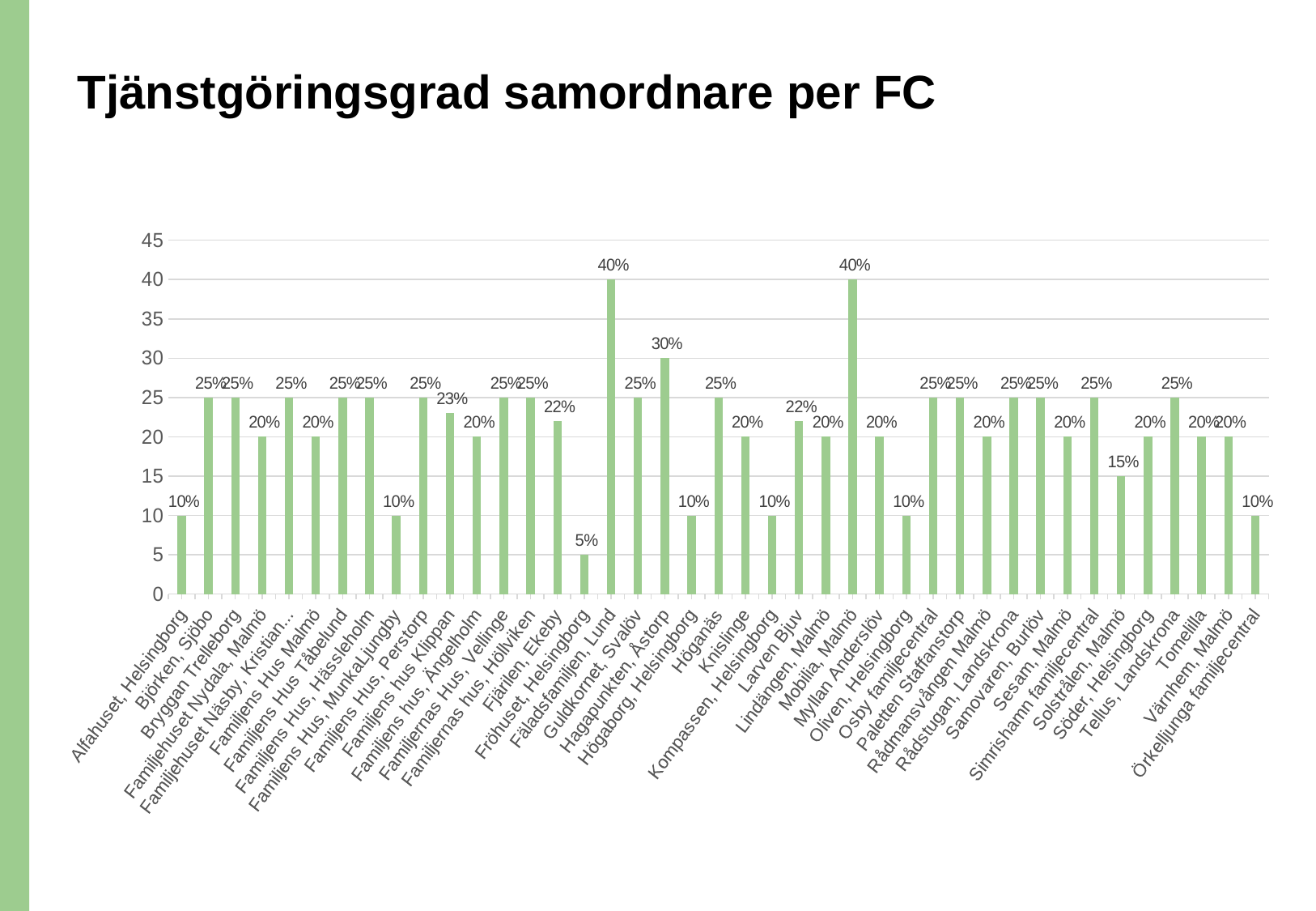
What is the value for Hagapunkten, Åstorp? 30% What is the title of the slide? Tjänstgöringsgrad samordnare per FC What is the value for Fjärilen, Ekeby? 22% What is the difference between the values for Hagapunkten, Åstorp and Alfahuset, Helsingborg? 20% What is the value for Fäladsfamiljen, Lund? 40% What kind of chart is shown on the slide? bar chart Which category has the lowest value? Fröhuset, Helsingborg What is the value for Familjens hus Klippan? 23% What is the difference between the values for Mobilia, Malmö and Sesam, Malmö? 20% Is the value for Larven Bjuv greater or less than 20? greater Which is larger, the value for Hagapunkten, Åstorp or the value for Guldkornet, Svalöv? Hagapunkten, Åstorp What is the value for Solstrålen, Malmö? 15%